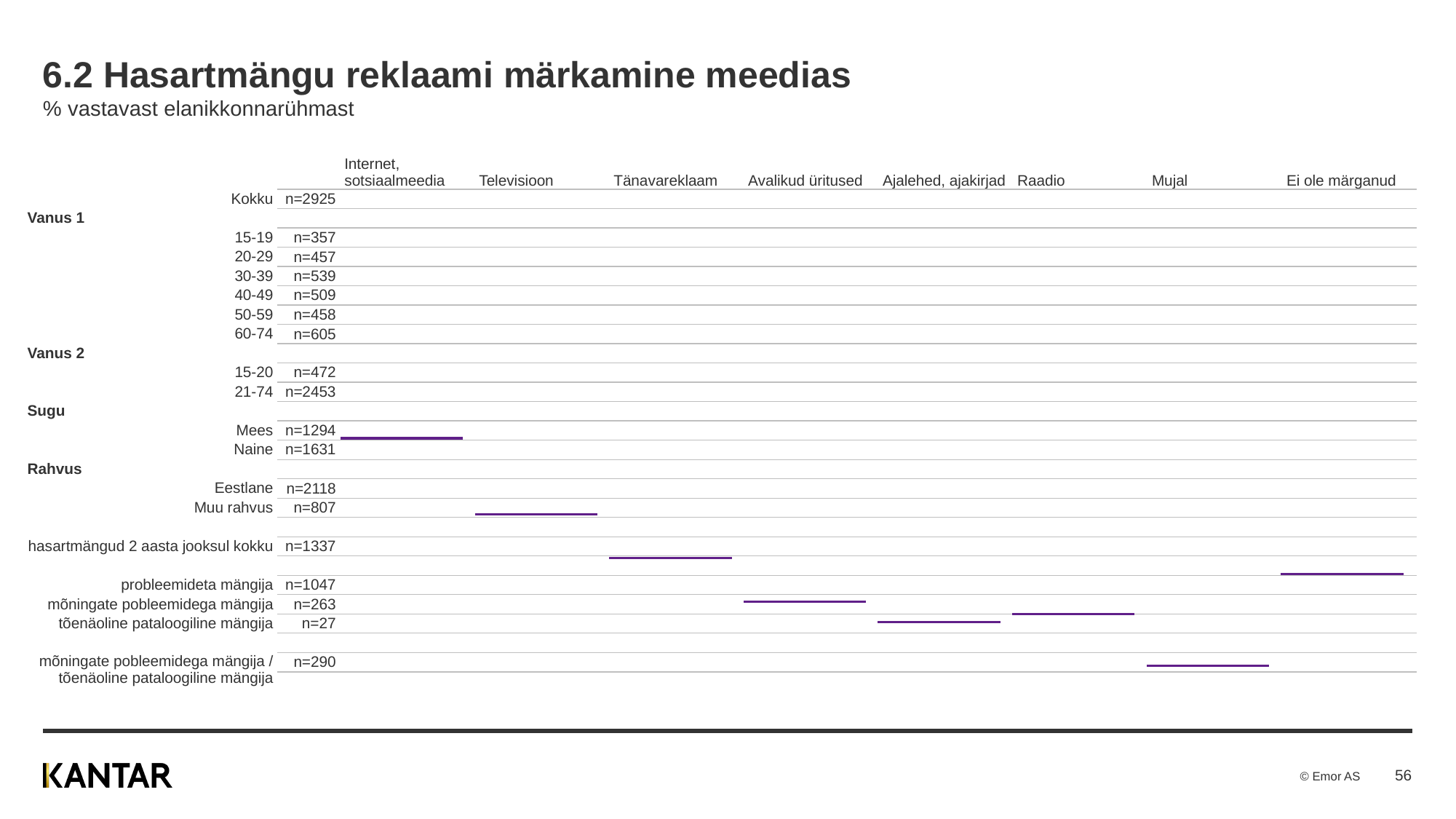
What sample size (n) is printed for the Naine row? n=1631 What unit or subtitle is shown under the chart title? % vastavast elanikkonnarühmast What is the title of the chart on the slide? 6.2 Hasartmängu reklaami märkamine meedias What sample size (n) is printed for the Mees row? n=1294 What sample size (n) is printed for the Kokku row? n=2925 What sample size (n) is printed for the 60-74 age group row? n=605 How many media categories are listed as column headers across the top of the chart? 8 What sample size (n) is printed for the tõenäoline pataloogiline mängija row? n=27 What is the difference between the printed sample sizes of Naine (n=1631) and Mees (n=1294)? 337 Which row has the larger printed sample size, Eestlane (n=2118) or Muu rahvus (n=807)? Eestlane What sample size (n) is printed for the Muu rahvus row? n=807